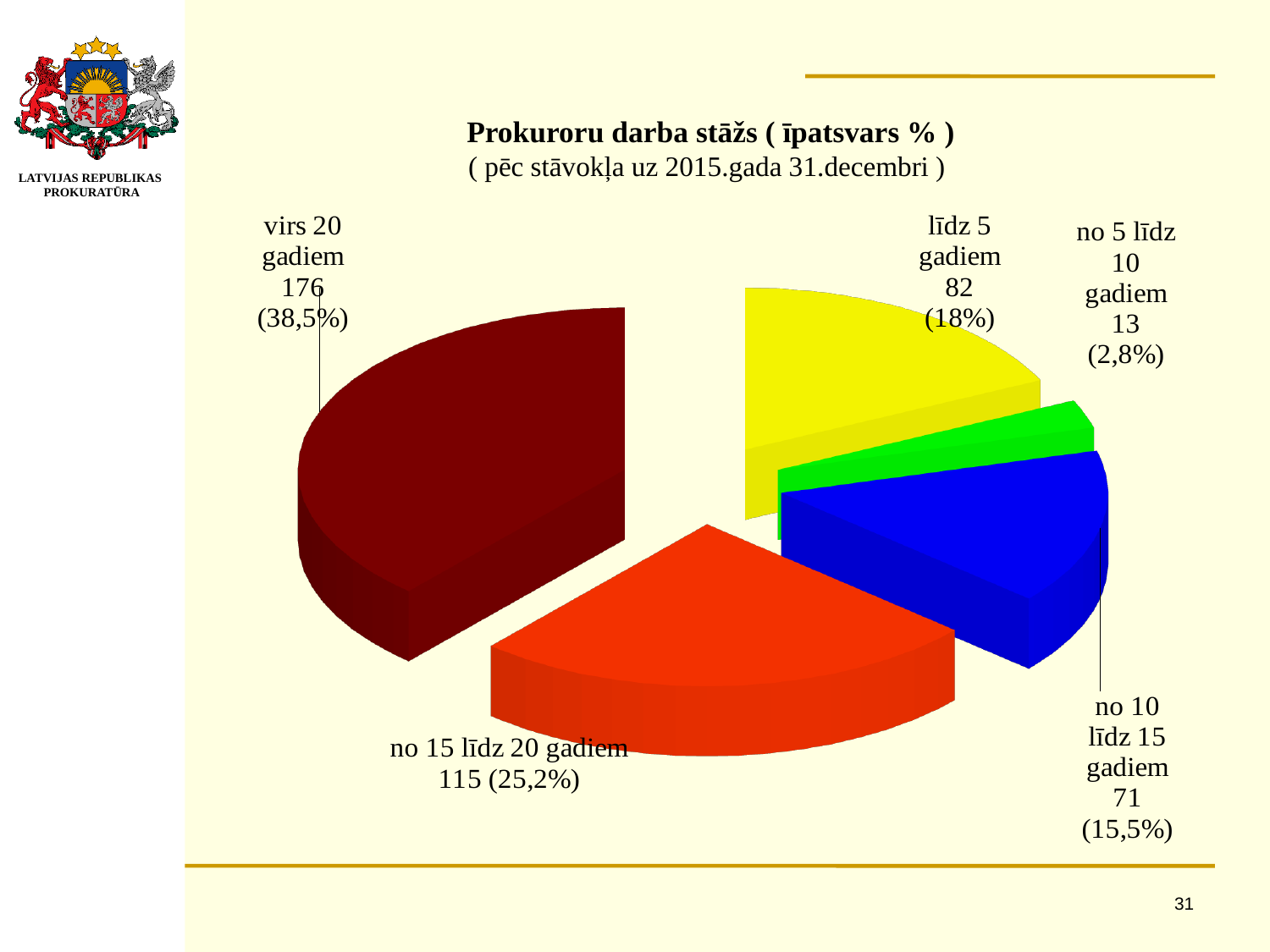
What colour is the slice for 'virs 20 gadiem'? dark red Which category has the largest slice of the pie? virs 20 gadiem What percentage is shown for 'no 5 līdz 10 gadiem'? 2,8% What is the value for 'līdz 5 gadiem'? 82 Which category has the smallest slice of the pie? no 5 līdz 10 gadiem Which is larger: the value for 'līdz 5 gadiem' or 'no 10 līdz 15 gadiem'? līdz 5 gadiem What is the difference between the values for 'virs 20 gadiem' and 'no 15 līdz 20 gadiem'? 61 What share of the pie does 'no 15 līdz 20 gadiem' represent? 25,2% How many categories does the pie chart have? 5 What kind of chart is shown on the slide? pie chart How many prosecutors have work experience of 'virs 20 gadiem'? 176 What is the value for 'no 10 līdz 15 gadiem'? 71